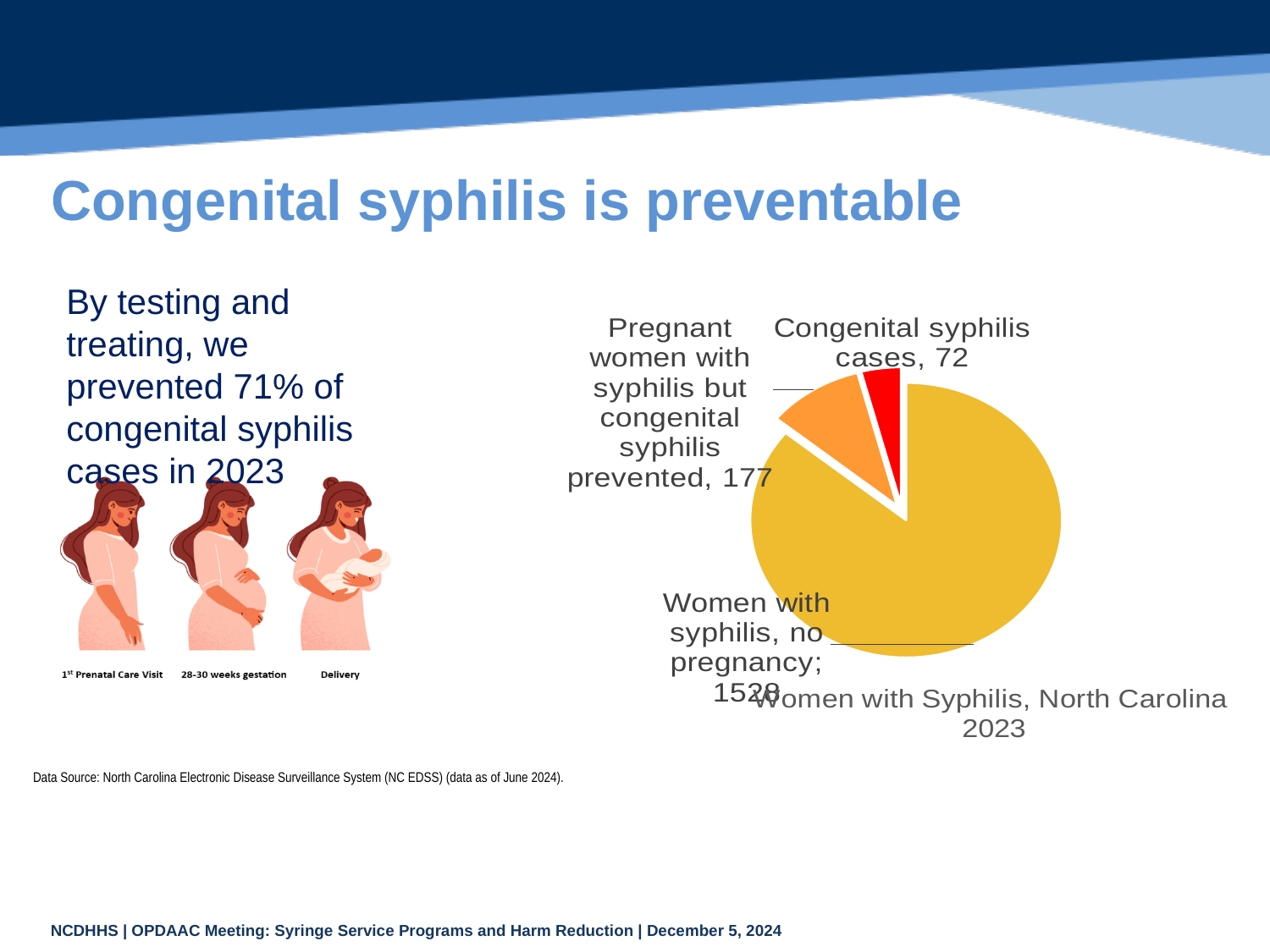
What is the difference between the 'Pregnant women with syphilis but congenital syphilis prevented' value and the 'Congenital syphilis cases' value? 105 Which is larger: the 'Congenital syphilis cases' slice or the 'Pregnant women with syphilis but congenital syphilis prevented' slice? Pregnant women with syphilis but congenital syphilis prevented Which slice of the pie chart is the smallest? Congenital syphilis cases What is the title of the pie chart? Women with Syphilis, North Carolina 2023 How many slices does the pie chart have? 3 Which slice of the pie chart is the largest? Women with syphilis, no pregnancy What colour is the 'Congenital syphilis cases' slice? red What type of chart is shown on the slide? pie chart What is the value for the 'Congenital syphilis cases' slice? 72 What is the value for the 'Pregnant women with syphilis but congenital syphilis prevented' slice? 177